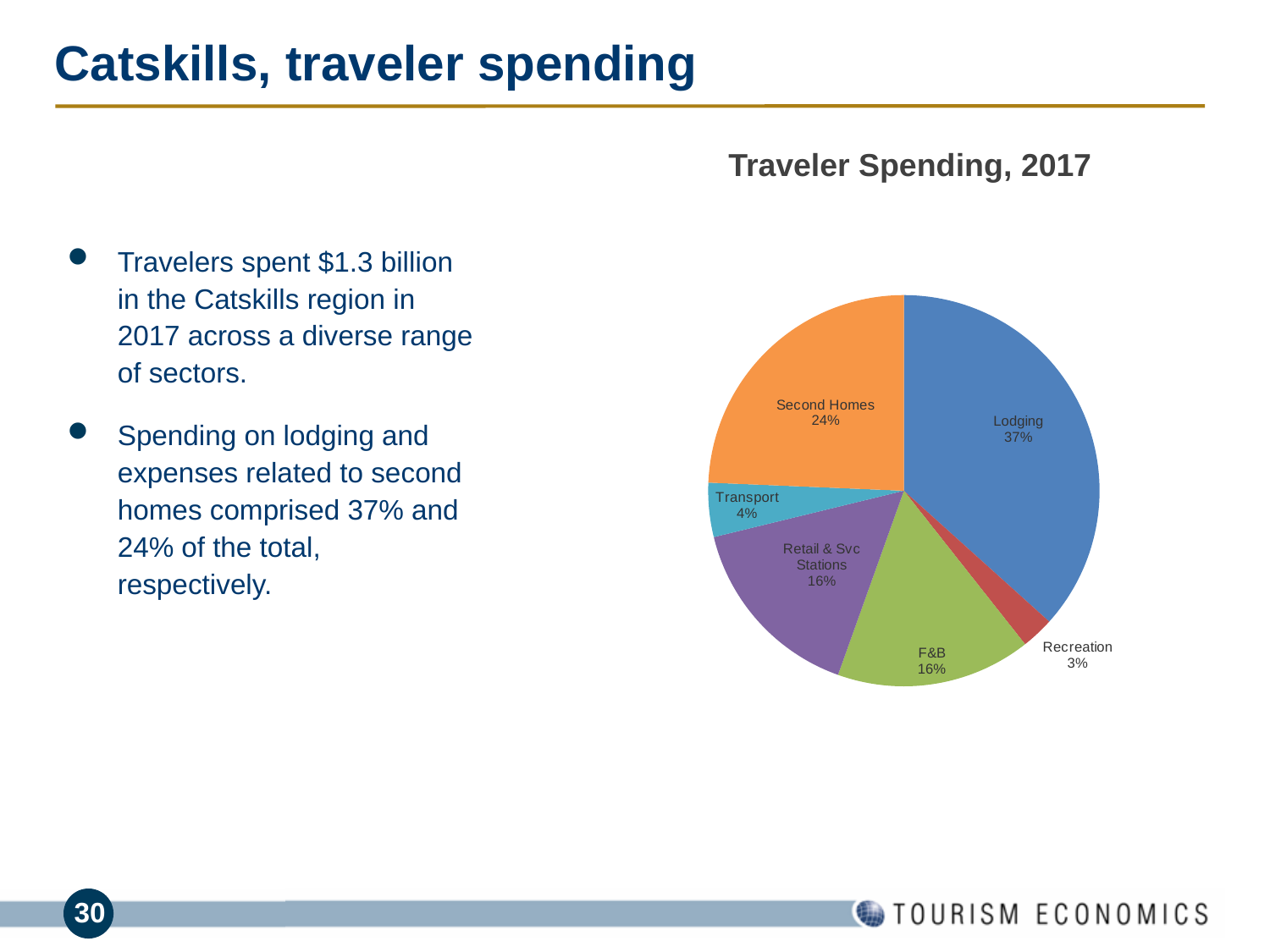
What share of traveler spending is Second Homes? 24% What type of chart is shown on the slide? pie chart What share of traveler spending is Recreation? 3% What is the difference in percentage points between Lodging and Second Homes? 13 What colour is the Lodging slice? blue Which is larger, the share for Second Homes or the share for Retail & Svc Stations? Second Homes What share of traveler spending is Lodging? 37% Which category has the smallest share of traveler spending? Recreation How many categories are shown in the pie chart? 6 What is the title of the chart? Traveler Spending, 2017 Which category has the largest share of traveler spending? Lodging